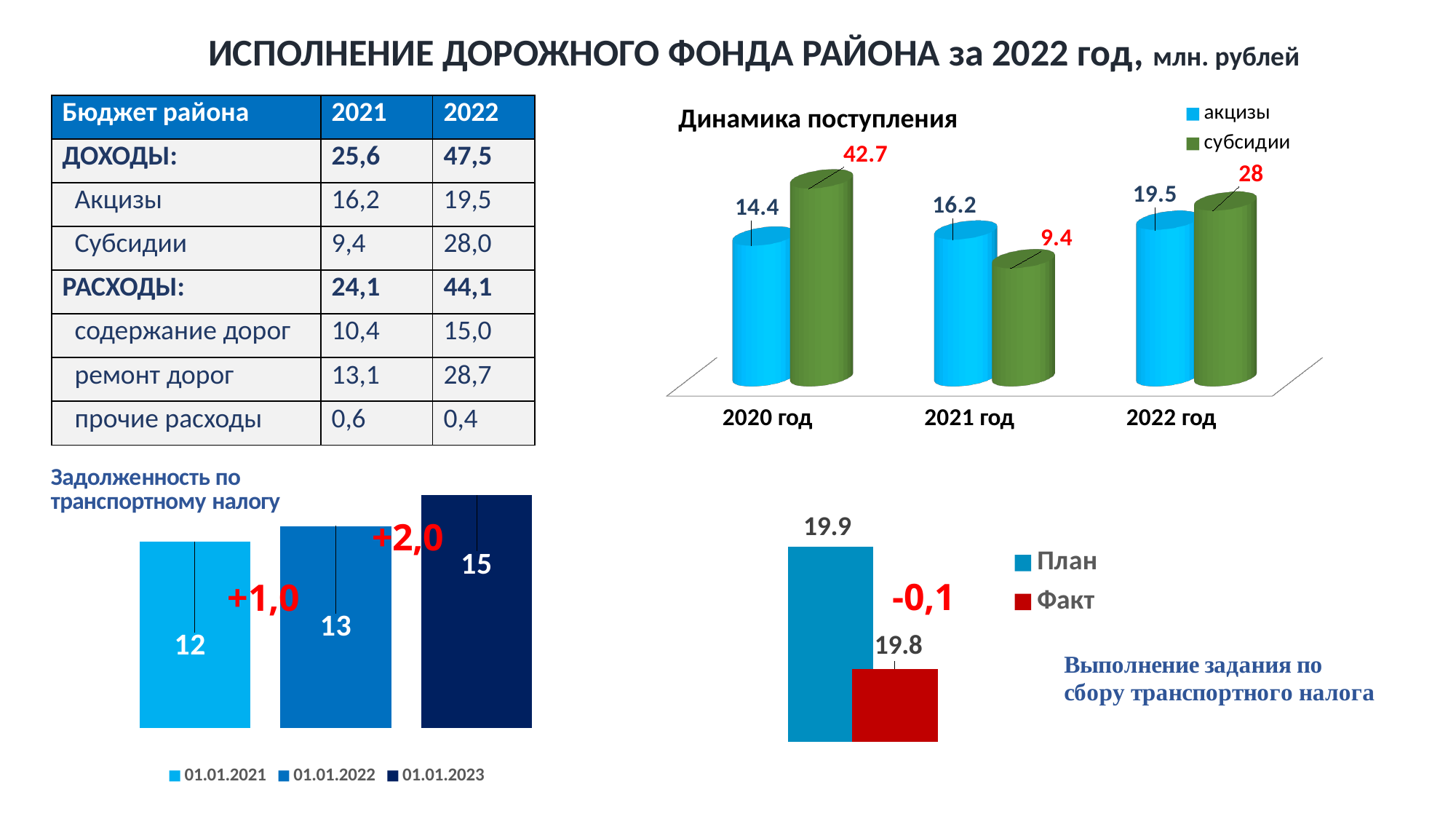
What kind of chart is the 'Выполнение задания по сбору транспортного налога' chart? bar chart In the 'Задолженность по транспортному налогу' chart, what is the value for 01.01.2022? 13 In the 'Выполнение задания по сбору транспортного налога' chart, which is larger, План or Факт? План In the 'Задолженность по транспортному налогу' chart, which date has the highest value? 01.01.2023 In the 'Задолженность по транспортному налогу' chart, how many bars are plotted? 3 In the 'Динамика поступления' chart, how many series does the legend list? 2 In the 'Динамика поступления' chart, which year has the lowest value for субсидии? 2021 год In the 'Динамика поступления' chart, what is the value for акцизы in 2021 год? 16.2 In the 'Выполнение задания по сбору транспортного налога' chart, what is the value for План? 19.9 In the 'Динамика поступления' chart, do the values for акцизы rise or fall from 2020 год to 2022 год? rise In the 'Динамика поступления' chart, what is the difference between субсидии and акцизы in 2022 год? 8.5 In the 'Динамика поступления' chart, what is the value for субсидии in 2020 год? 42.7